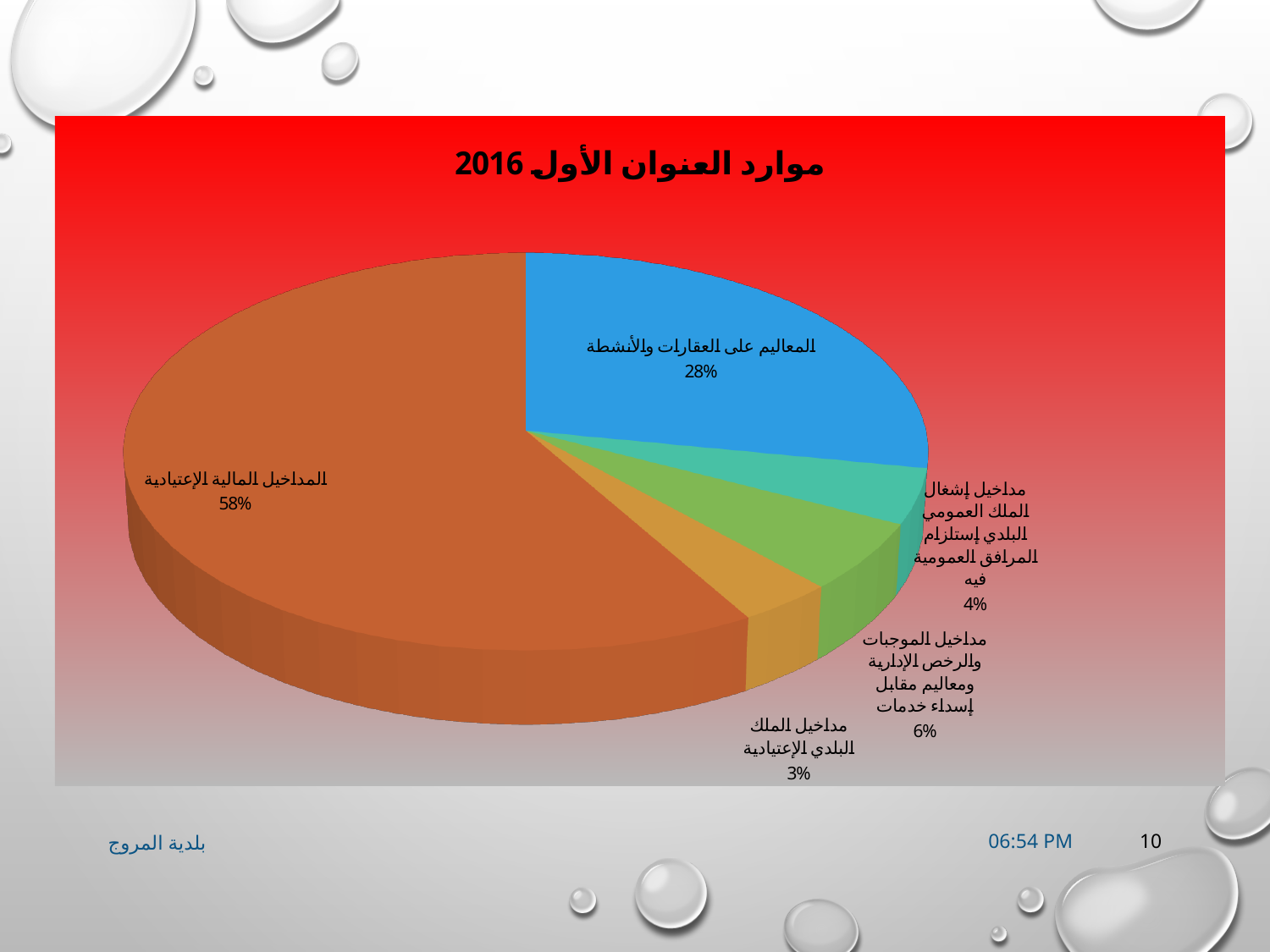
Which category has the smallest share of the pie? مداخيل الملك البلدي الإعتيادية How many slices does the pie chart have? 5 What share of the pie is المداخيل المالية الإعتيادية? 58% What kind of chart is shown on the slide? Pie chart Which category has the largest share of the pie? المداخيل المالية الإعتيادية What is the title of the chart? موارد العنوان الأول 2016 What share of the pie is مداخيل إشغال الملك العمومي البلدي إستلزام المرافق العمومية فيه? 4% Which is larger: the share for مداخيل الموجبات والرخص الإدارية ومعاليم مقابل إسداء خدمات or the share for مداخيل إشغال الملك العمومي البلدي إستلزام المرافق العمومية فيه? مداخيل الموجبات والرخص الإدارية ومعاليم مقابل إسداء خدمات What share of the pie is المعاليم على العقارات والأنشطة? 28% What is the difference in percentage points between المداخيل المالية الإعتيادية and المعاليم على العقارات والأنشطة? 30 percentage points